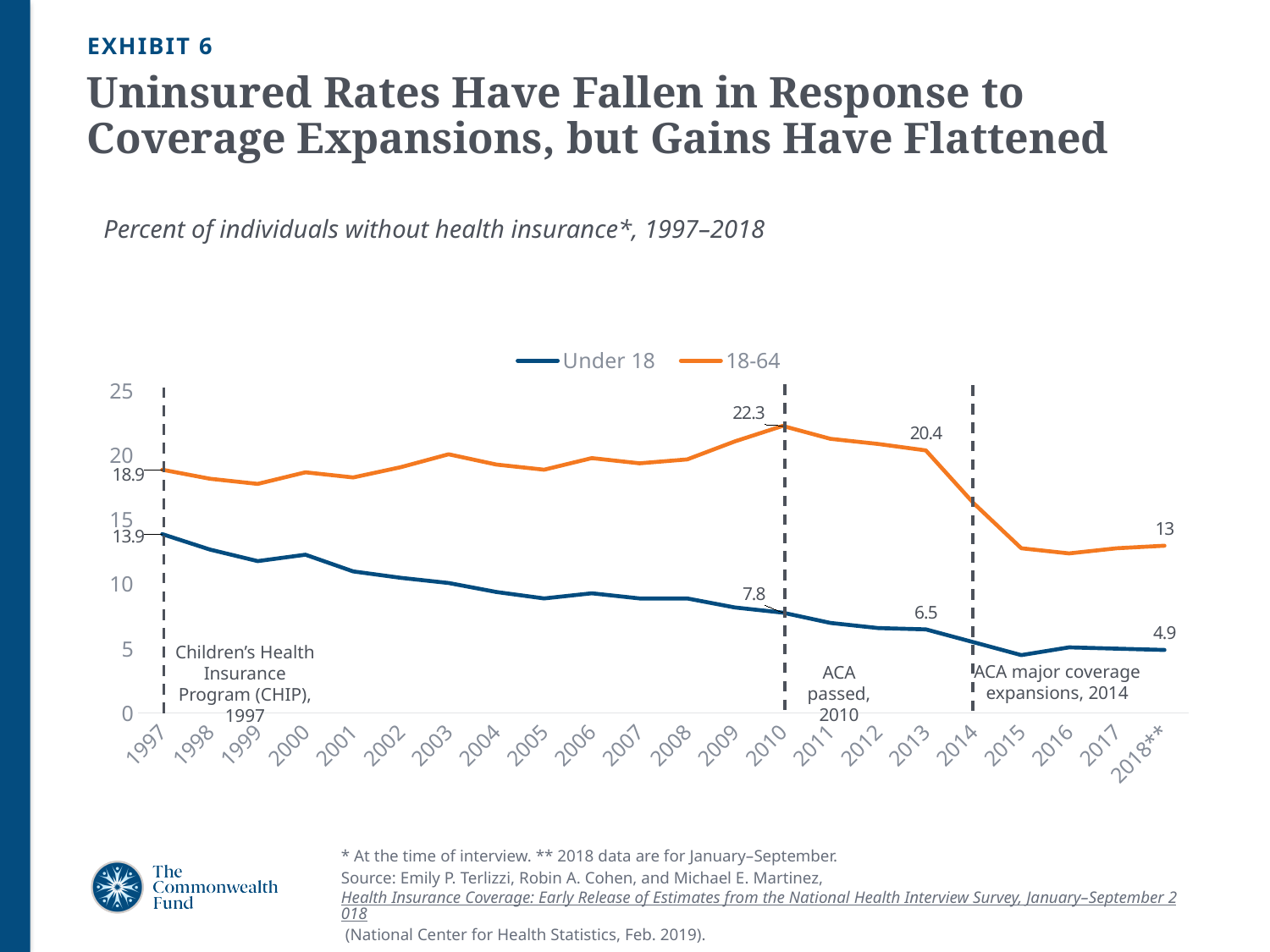
Is the value for the 18-64 group in 2015 greater or less than 15? less What was the uninsured rate for the 18-64 group in 2013? 20.4 What is the difference between the 18-64 rate and the Under 18 rate in 2010? 14.5 Does the Under 18 uninsured rate generally rise or fall from 1997 to 2018**? fall What was the uninsured rate for the Under 18 group in 2018**? 4.9 What was the uninsured rate for the Under 18 group in 2010? 7.8 What was the uninsured rate for the 18-64 group in 1997? 18.9 Which series has the higher uninsured rate in 2013, Under 18 or 18-64? 18-64 By how much did the Under 18 uninsured rate fall from 1997 to 2018**? 9 How many series does the legend list? 2 What colour is the line for the 18-64 series? orange What type of chart is shown on the slide? line chart